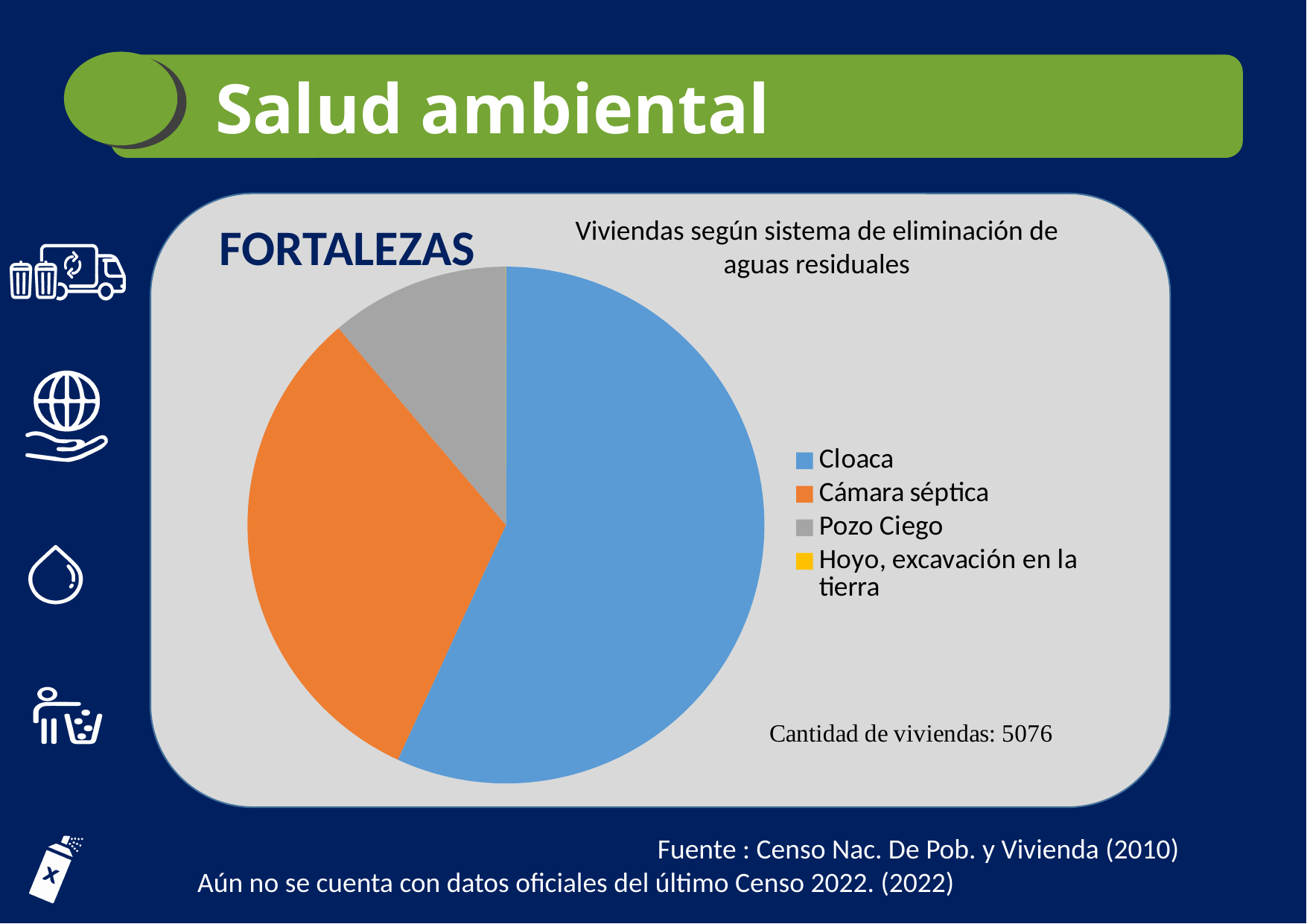
What is the title of the chart? Viviendas según sistema de eliminación de aguas residuales Which slice is larger, Cloaca or Cámara séptica? Cloaca What colour represents Cámara séptica in the chart? Orange What kind of chart is shown on the slide? Pie chart Which category has the largest slice of the pie? Cloaca How many categories does the chart's legend list? 4 Which of the visible slices is the smallest: Cloaca, Cámara séptica or Pozo Ciego? Pozo Ciego Which slice is larger, Cámara séptica or Pozo Ciego? Cámara séptica Does the Cloaca slice represent more or less than half of the pie? more Which legend entry is represented by the yellow colour? Hoyo, excavación en la tierra What is the total number of viviendas stated on the chart? 5076